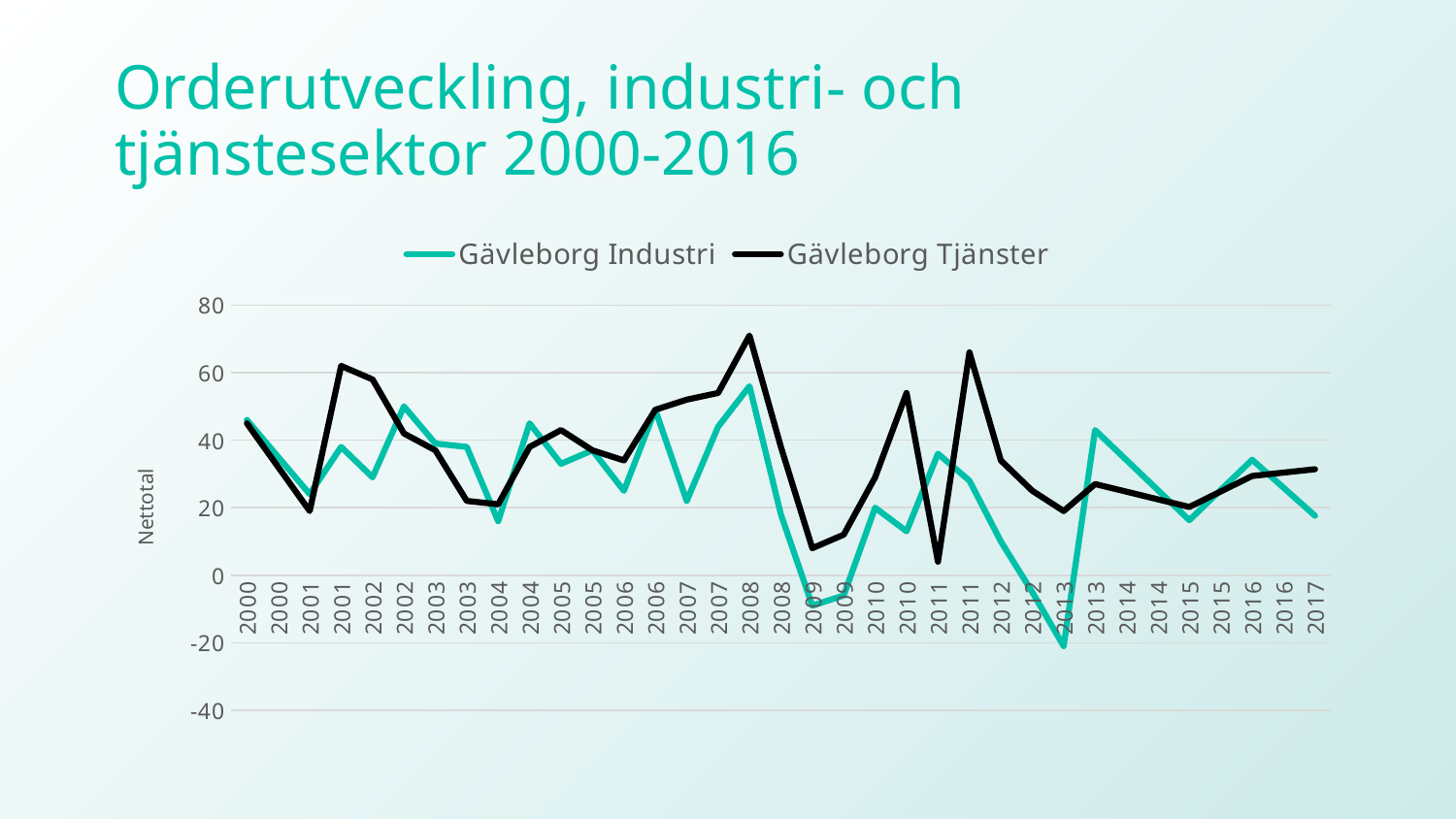
Is the value for Gävleborg Industri at the first 2008 point greater or less than 40? greater At the second 2013 point, which series has the higher value, Gävleborg Industri or Gävleborg Tjänster? Gävleborg Industri At the first 2008 point, which series has the higher value, Gävleborg Industri or Gävleborg Tjänster? Gävleborg Tjänster Is the value for Gävleborg Tjänster at the first 2009 point greater or less than 20? less How many series does the legend list? 2 Is the lowest value of Gävleborg Industri in 2013 greater or less than 0? less What is the title of the chart on the slide? Orderutveckling, industri- och tjänstesektor 2000-2016 In which year does the Gävleborg Industri series reach its lowest value? 2013 What is the label on the vertical axis? Nettotal In which year does the Gävleborg Tjänster series reach its highest value? 2008 What kind of chart is shown on the slide? Line chart